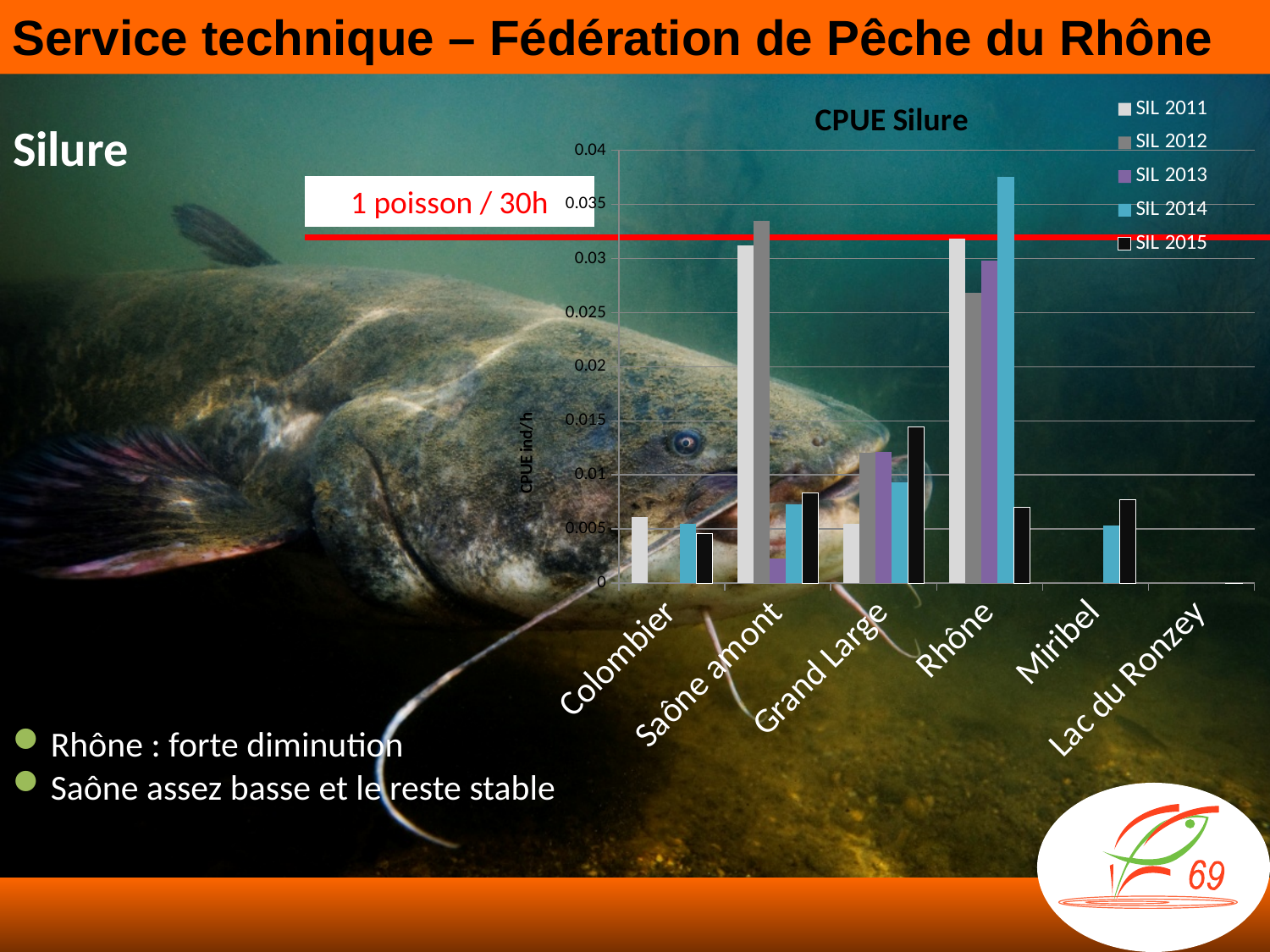
How many series does the legend of the CPUE Silure chart list? 5 Is the SIL 2015 value for Rhône greater or less than 0.01? less Is the SIL 2014 value for Rhône greater or less than 0.035? greater Which is larger: the SIL 2014 value for Rhône or the SIL 2014 value for Saône amont? Rhône Is the SIL 2012 value for Saône amont greater or less than 0.03? greater What is the title of the chart? CPUE Silure How many categories are shown on the x axis of the CPUE Silure chart? 6 Which category has the highest SIL 2014 bar? Rhône Which category has the highest SIL 2012 bar? Saône amont Which is larger: the SIL 2015 value for Saône amont or the SIL 2015 value for Colombier? Saône amont What kind of chart is shown on the slide? bar chart